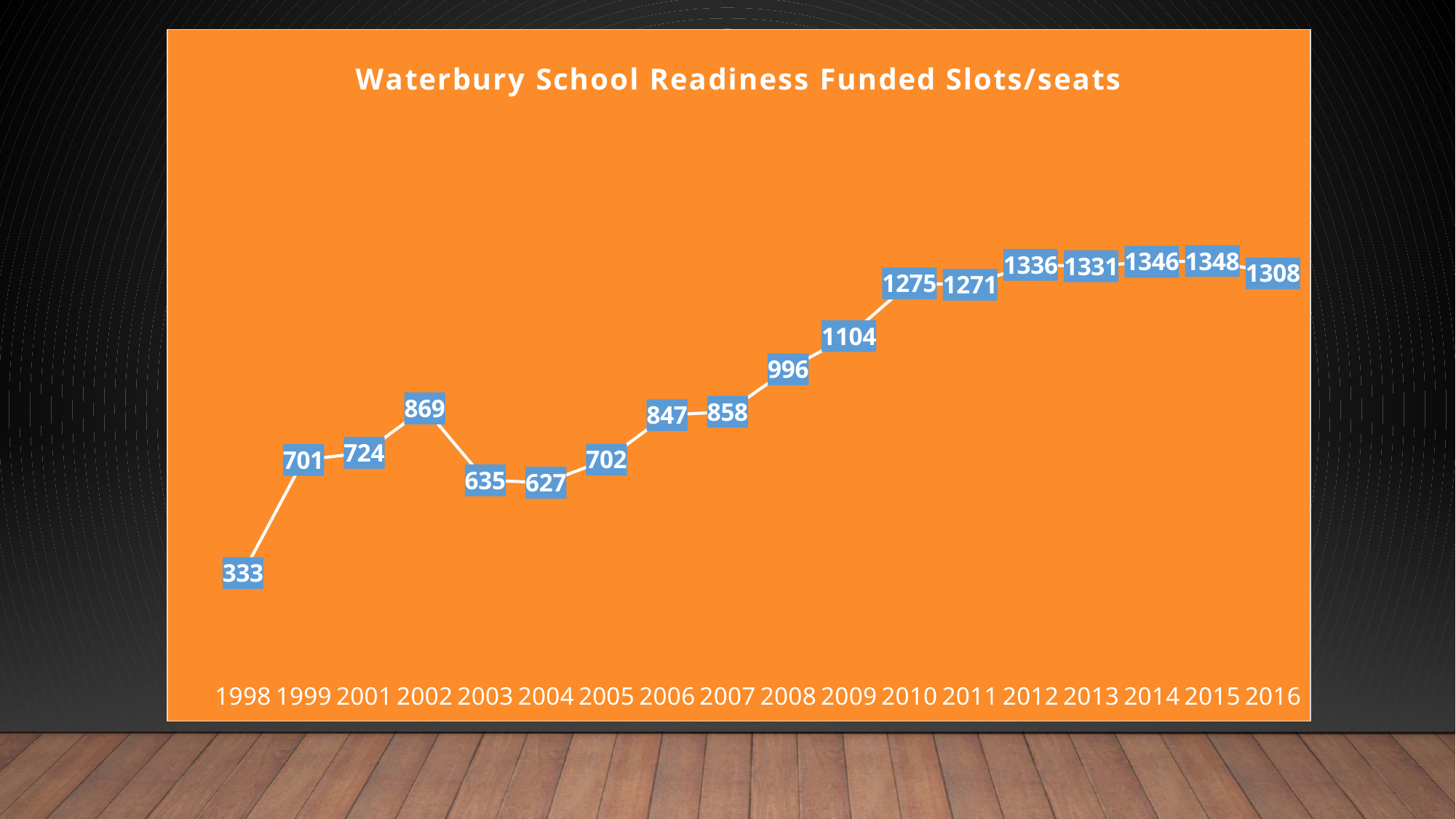
What is the title of the chart? Waterbury School Readiness Funded Slots/seats What is the value for 2009? 1104 How many years are plotted on the x axis? 18 What is the value for 2016? 1308 By how much did the value drop from 2002 to 2003? 234 What is the difference between the values for 2016 and 1998? 975 What type of chart is shown on the slide? line chart Which year has the lowest number of funded slots/seats? 1998 Which year has the highest number of funded slots/seats? 2015 How many funded slots/seats are shown for 1998? 333 Which year has the larger value, 2002 or 2005? 2002 Overall, do the values rise or fall from 1998 to 2016? rise